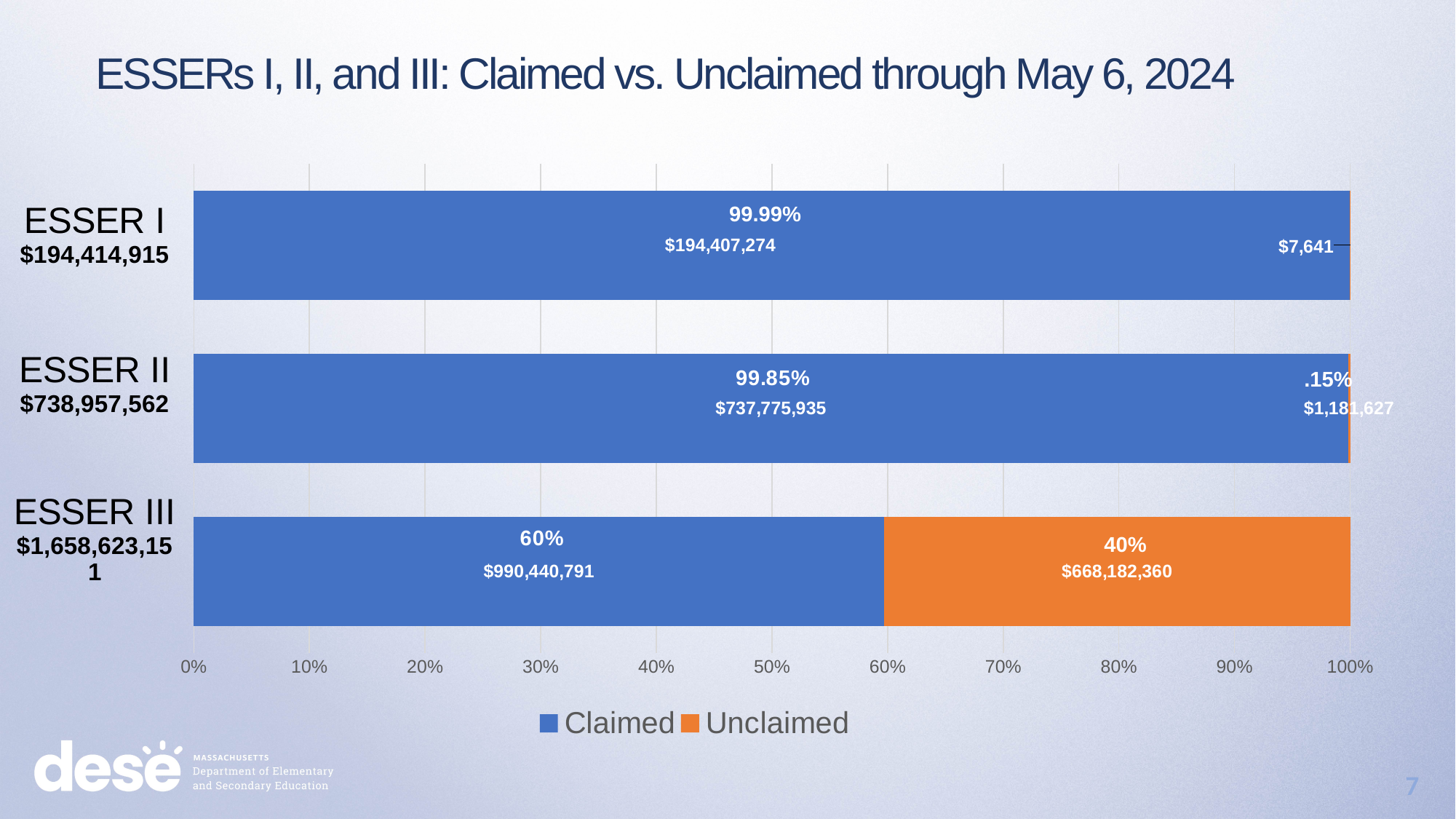
How many series does the legend list? 2 Which is larger for ESSER III, the Claimed share or the Unclaimed share? Claimed What kind of chart is shown on the slide? Stacked bar chart What percentage of ESSER III funds is Claimed? 60% Which ESSER program has the lowest Claimed percentage? ESSER III What is the title of the chart? ESSERs I, II, and III: Claimed vs. Unclaimed through May 6, 2024 How many ESSER categories are plotted in the chart? 3 What is the Claimed dollar amount for ESSER II? $737,775,935 What percentage of ESSER II funds is Claimed? 99.85% Which ESSER program has the highest Claimed percentage? ESSER I What is the Unclaimed dollar amount for ESSER III? $668,182,360 What is the Unclaimed dollar amount for ESSER I? $7,641